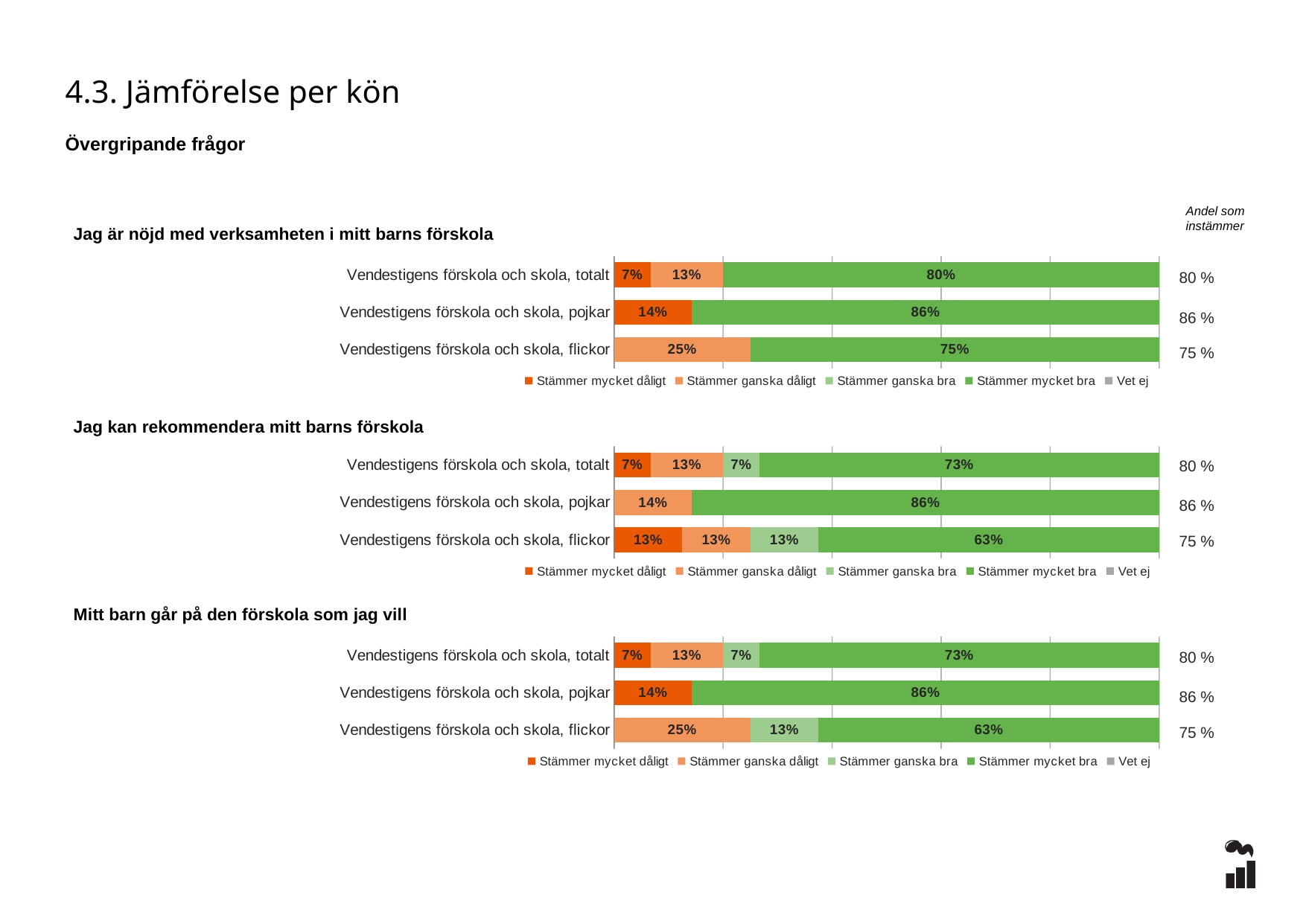
In the chart 'Mitt barn går på den förskola som jag vill', which category has the lowest 'Stämmer mycket bra' value? Vendestigens förskola och skola, flickor How many series does the legend of the chart 'Jag kan rekommendera mitt barns förskola' list? 5 What kind of chart is 'Mitt barn går på den förskola som jag vill'? Stacked bar chart In the chart 'Mitt barn går på den förskola som jag vill', what is the 'Stämmer mycket dåligt' value for 'Vendestigens förskola och skola, pojkar'? 14% In the chart 'Mitt barn går på den förskola som jag vill', which is larger: the 'Stämmer ganska dåligt' value for totalt or for flickor? flickor In the chart 'Jag är nöjd med verksamheten i mitt barns förskola', which category has the highest 'Stämmer mycket bra' value? Vendestigens förskola och skola, pojkar In the chart 'Jag kan rekommendera mitt barns förskola', what is the difference between the 'Stämmer mycket bra' values for pojkar and flickor? 23% In the chart 'Jag är nöjd med verksamheten i mitt barns förskola', what is the 'Stämmer mycket bra' value for 'Vendestigens förskola och skola, totalt'? 80% In the chart 'Jag är nöjd med verksamheten i mitt barns förskola', what is the 'Stämmer ganska dåligt' value for 'Vendestigens förskola och skola, flickor'? 25% In the chart 'Jag kan rekommendera mitt barns förskola', what is the 'Stämmer ganska bra' value for 'Vendestigens förskola och skola, totalt'? 7% How many categories are shown in the chart 'Jag är nöjd med verksamheten i mitt barns förskola'? 3 In the chart 'Jag kan rekommendera mitt barns förskola', what is the 'Stämmer mycket bra' value for 'Vendestigens förskola och skola, flickor'? 63%